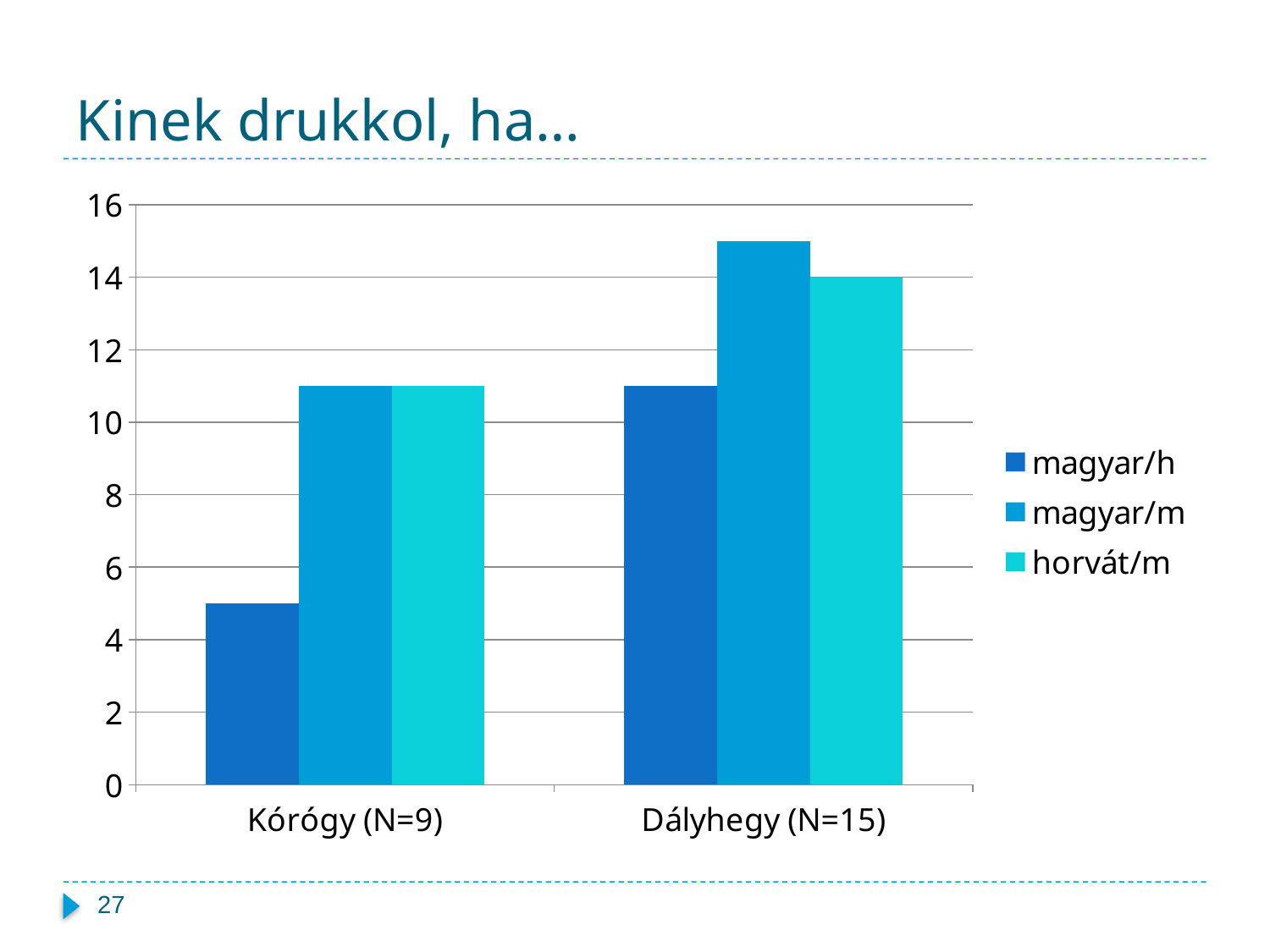
What kind of chart is shown on the slide? bar chart Which series has the highest value in Dályhegy (N=15)? magyar/m What is the value for horvát/m in Dályhegy (N=15)? 14 How many categories are shown on the x axis? 2 Which is larger: magyar/h in Kórógy (N=9) or magyar/h in Dályhegy (N=15)? Dályhegy (N=15) Is the value for magyar/m in Kórógy (N=9) greater or less than 12? less Is the value for magyar/h in Kórógy (N=9) greater or less than 6? less Which series has the lowest value in Kórógy (N=9)? magyar/h Is the value for magyar/h in Dályhegy (N=15) greater or less than 10? greater How many series does the legend list? 3 What is the title of the slide? Kinek drukkol, ha…